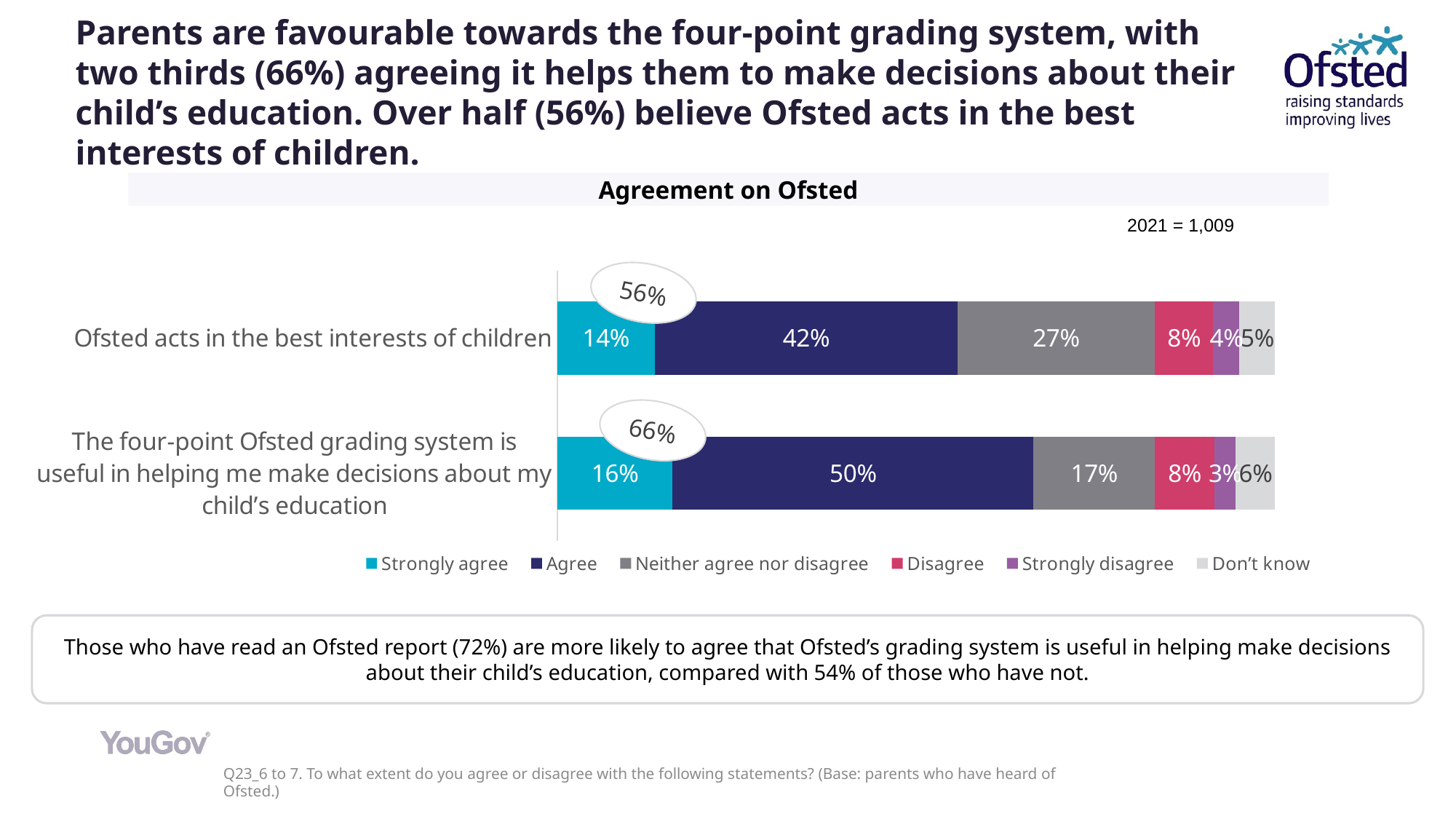
What percentage of parents strongly agree that Ofsted acts in the best interests of children? 14% What is the difference between the 'Neither agree nor disagree' percentages for the two statements? 10 percentage points What is the title of the chart? Agreement on Ofsted How many response categories does the legend list? 6 What is the difference between the 'Strongly agree' percentages for the two statements? 2 percentage points Which statement has the higher 'Agree' percentage? The four-point Ofsted grading system is useful in helping me make decisions about my child's education What percentage of parents answered 'Don't know' for the statement about the four-point grading system being useful? 6% What is the combined agreement (strongly agree plus agree) shown in the callout for 'Ofsted acts in the best interests of children'? 56% What percentage of parents agree that the four-point Ofsted grading system is useful in helping them make decisions about their child's education? 50% What type of chart is shown on the slide? Stacked bar chart How many statements are plotted in the chart? 2 What percentage of parents neither agree nor disagree that Ofsted acts in the best interests of children? 27%